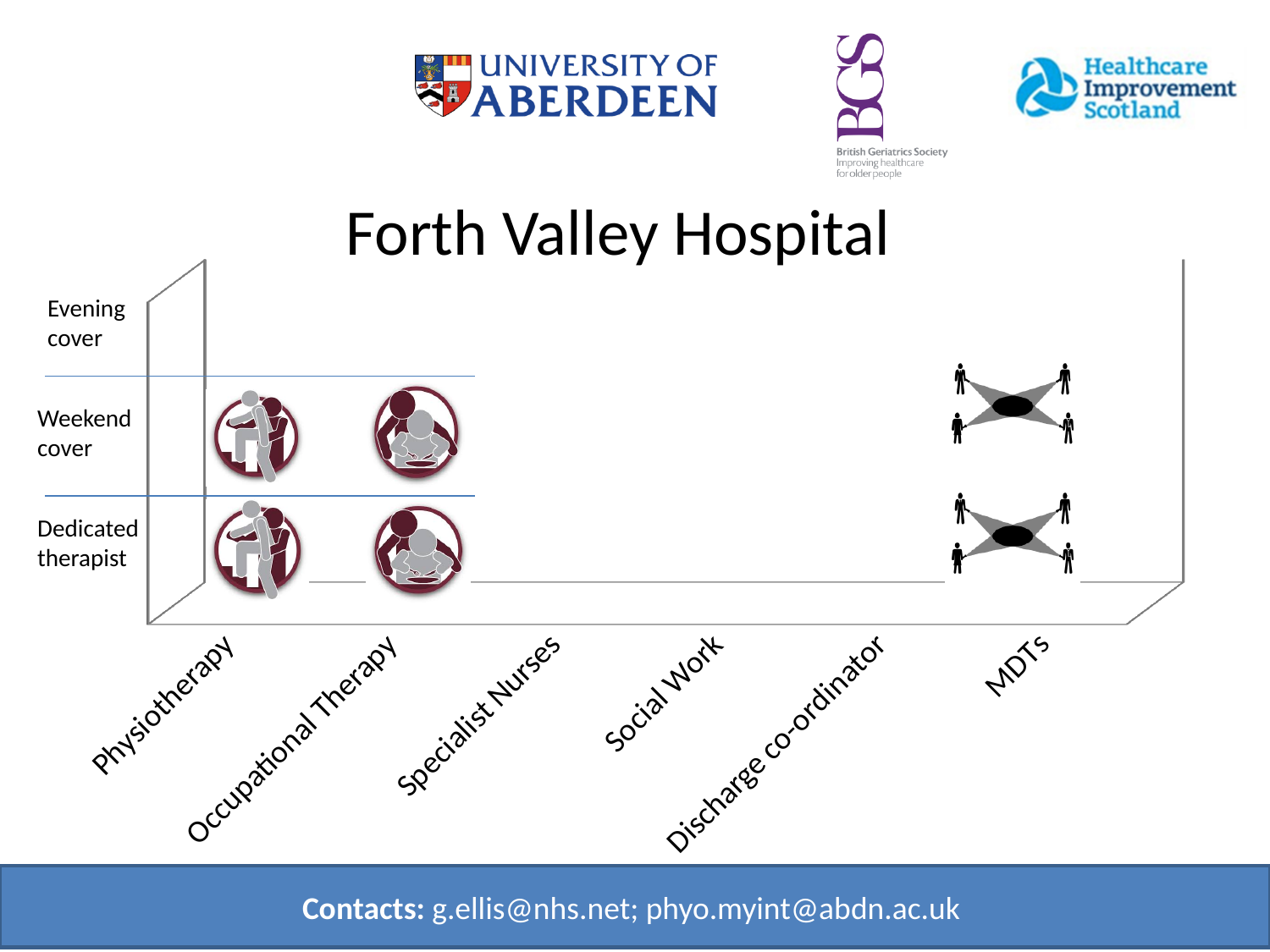
What is the label of the last category on the x axis of the chart? MDTs Does any category on the chart have an icon at the Evening cover level? No How many categories are shown along the x axis of the chart? 6 How many icons are stacked for MDTs on the chart? 2 Which categories on the chart have icons reaching the Weekend cover level? Physiotherapy, Occupational Therapy, MDTs Which has more icons on the chart, Occupational Therapy or Specialist Nurses? Occupational Therapy How many icons are stacked for Physiotherapy on the chart? 2 What are the three levels labelled on the vertical axis of the chart? Dedicated therapist, Weekend cover, Evening cover What is the label of the first category on the x axis of the chart? Physiotherapy What is the title of the chart? Forth Valley Hospital Which categories on the chart have no icons at all? Specialist Nurses, Social Work, Discharge co-ordinator Does Social Work reach the Dedicated therapist level on the chart? No